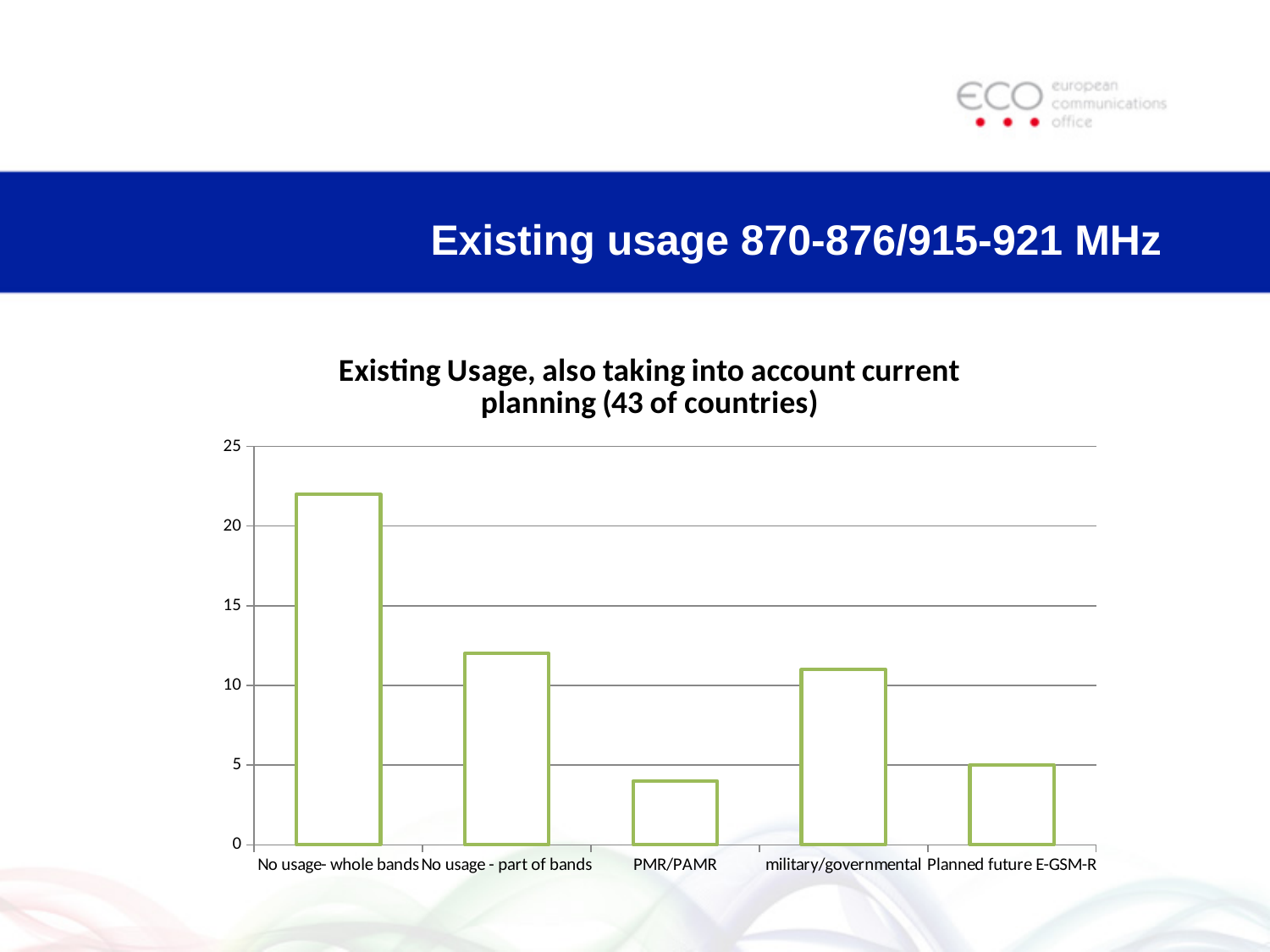
Which is larger, the value for military/governmental or the value for PMR/PAMR? military/governmental Which is larger, the value for No usage- whole bands or the value for No usage - part of bands? No usage- whole bands What type of chart is shown on the slide? bar chart Which category has the highest value? No usage- whole bands What is the value for Planned future E-GSM-R? 5 How many categories are shown on the x axis of the chart? 5 Is the value for PMR/PAMR greater or less than 5? less Is the value for military/governmental greater or less than 15? less What is the title of the chart? Existing Usage, also taking into account current planning (43 of countries) Which category has the lowest value? PMR/PAMR Is the value for No usage- whole bands greater or less than 20? greater